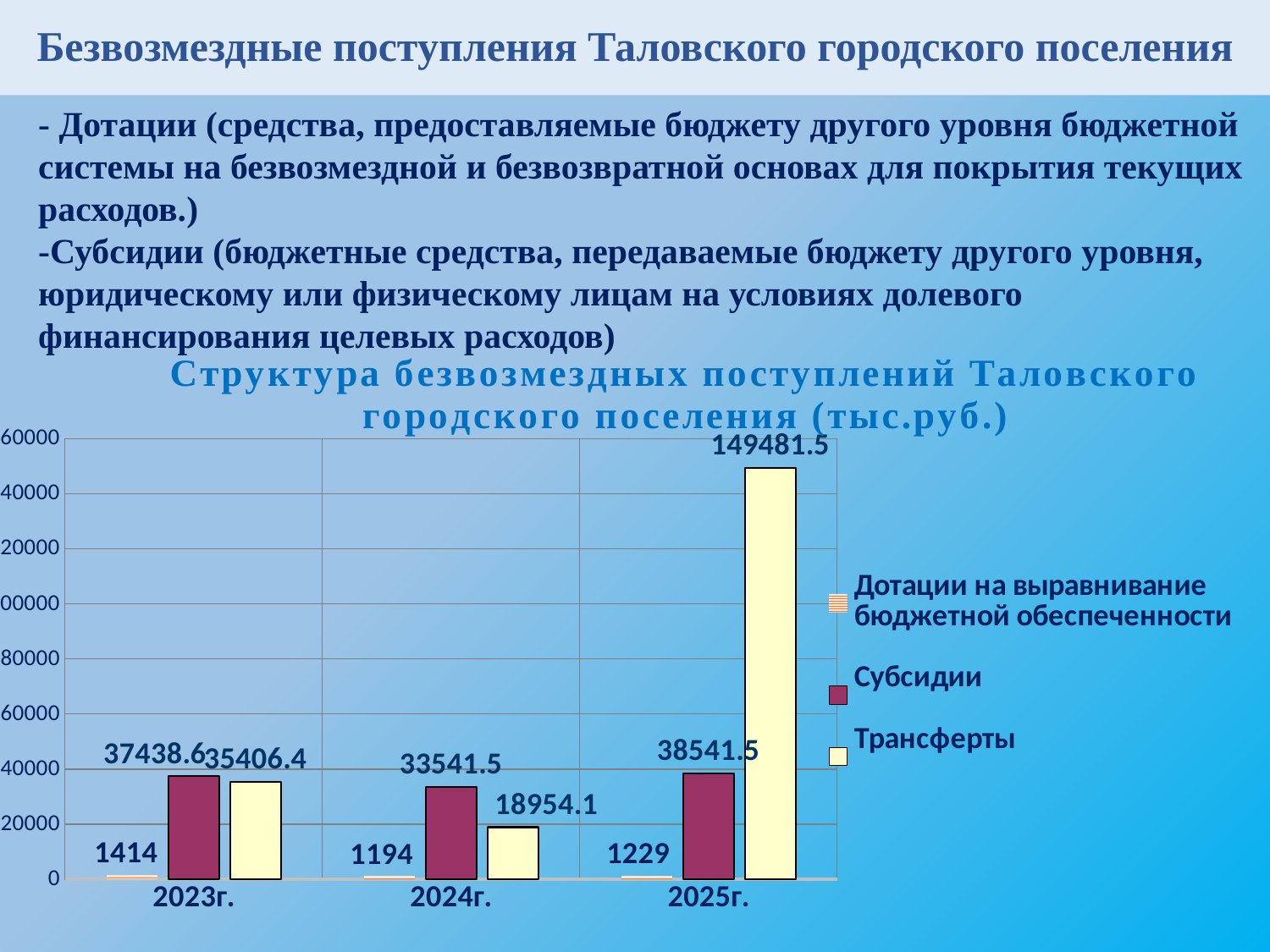
In which year is the value of Субсидии the highest? 2025г. What is the value of Дотации на выравнивание бюджетной обеспеченности for 2023г.? 1414 What type of chart is shown on the slide? bar chart How many series does the legend list? 3 What is the difference between Субсидии in 2025г. and Субсидии in 2024г.? 5000 What is the value of Субсидии for 2024г.? 33541.5 How many years are shown on the x axis? 3 In which year is the value of Трансферты the lowest? 2024г. Does the value of Трансферты rise or fall from 2023г. to 2024г.? fall What is the title of the chart? Структура безвозмездных поступлений Таловского городского поселения (тыс.руб.) Which is larger in 2023г.: Субсидии or Трансферты? Субсидии What is the value of Трансферты for 2025г.? 149481.5